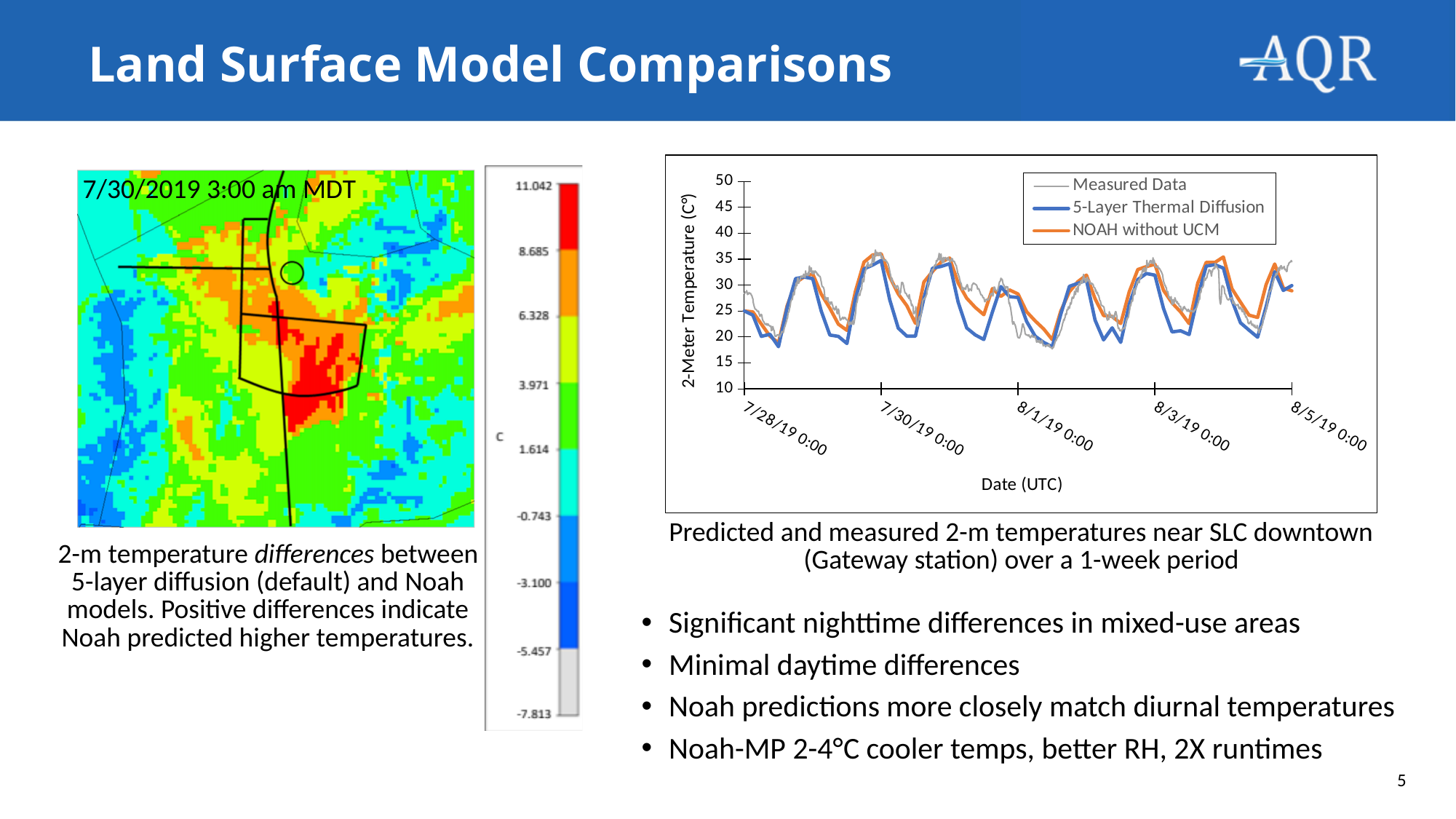
How many series does the legend of the right-hand temperature chart list? 3 How many date tick labels are shown on the x-axis of the right-hand temperature chart? 5 What is the y-axis label of the right-hand temperature chart? 2-Meter Temperature (C°) What are the three legend entries on the right-hand temperature chart? Measured Data, 5-Layer Thermal Diffusion, NOAH without UCM On the right-hand temperature chart, which series dips lower at the nighttime minima, 5-Layer Thermal Diffusion or NOAH without UCM? 5-Layer Thermal Diffusion On the colour scale of the left-hand temperature difference map, what is the lowest value printed? -7.813 On the colour scale of the left-hand temperature difference map, what is the highest value printed? 11.042 On the right-hand temperature chart, is the highest value reached by the NOAH without UCM series greater or less than 30? greater What kind of chart is the 'Predicted and measured 2-m temperatures' chart on the right? line chart On the right-hand temperature chart, is the highest value reached by the 5-Layer Thermal Diffusion series greater or less than 40? less On the right-hand temperature chart, is the lowest value reached by the 5-Layer Thermal Diffusion series greater or less than 15? greater